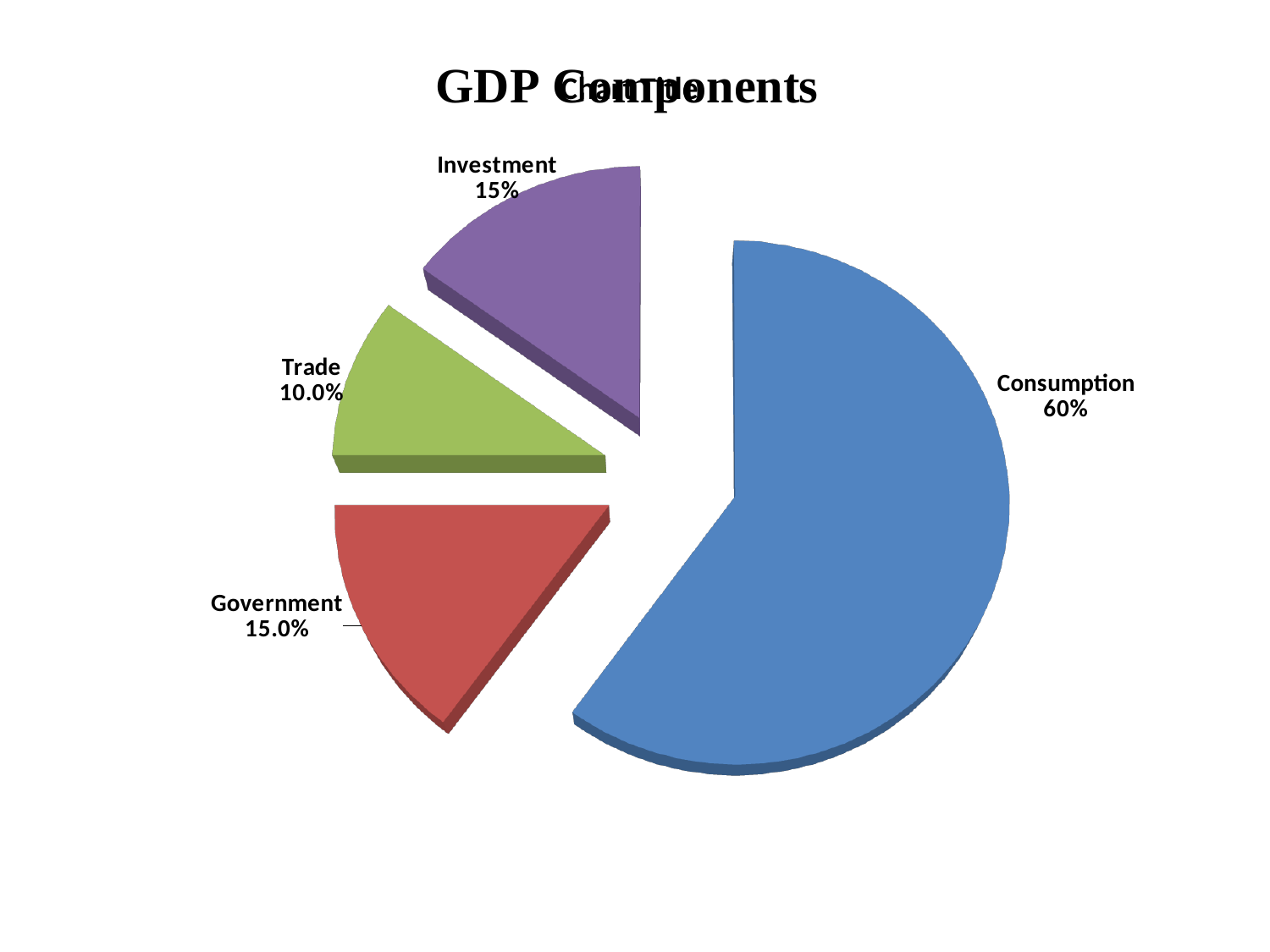
What colour is the Consumption slice? blue By how many percentage points does Government exceed Trade? 5 What kind of chart is shown on the slide? pie chart Which component has the largest slice of the pie? Consumption What is the value shown for Government? 15.0% How many slices does the pie chart have? 4 By how many percentage points does Consumption exceed Trade? 50 What is the value shown for Investment? 15% What share of the pie does Consumption have? 60% Which component has the smallest slice of the pie? Trade Which is larger, the Consumption slice or the Investment slice? Consumption What is the value shown for Trade? 10.0%